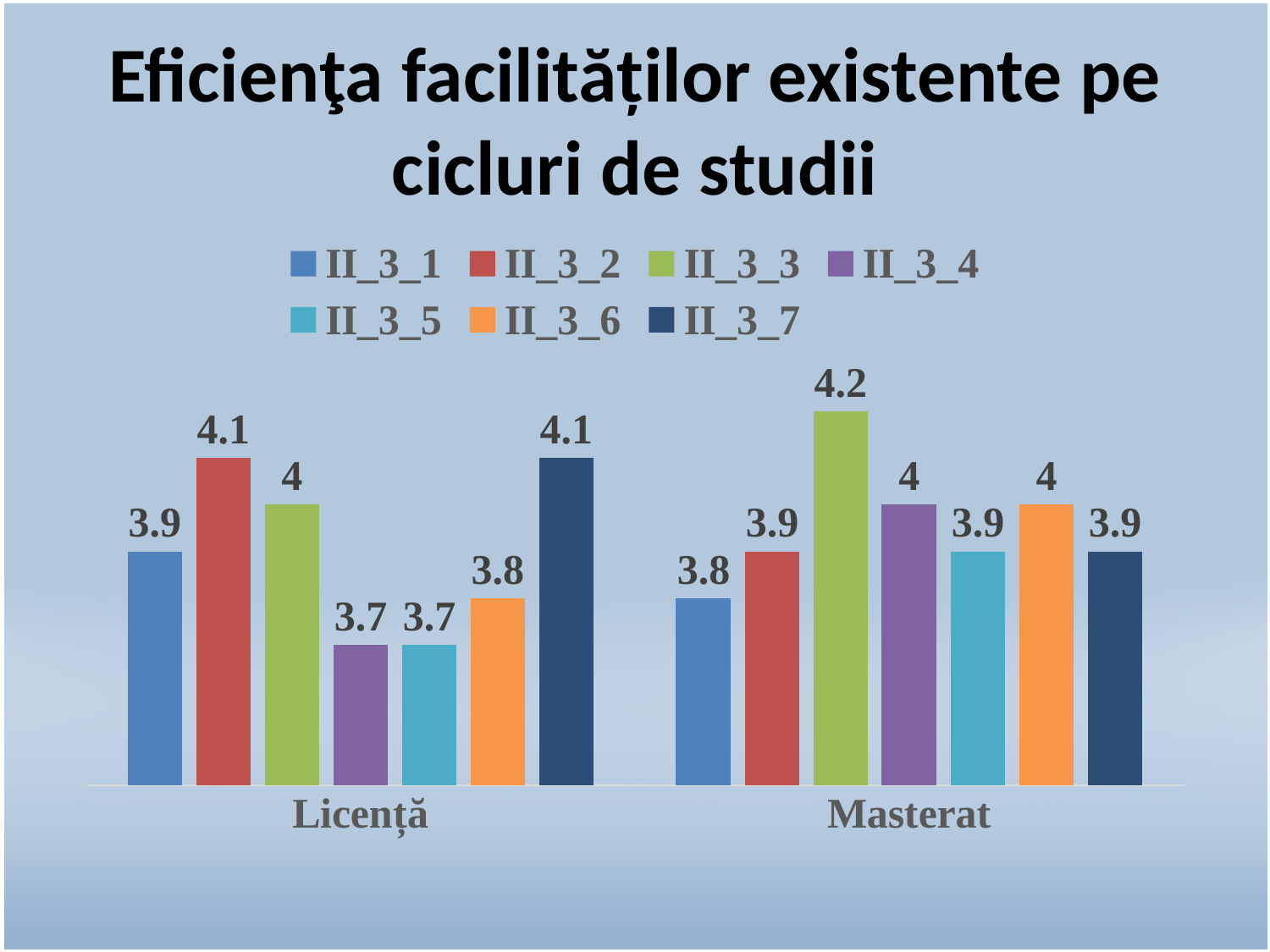
Which series has the highest value for Masterat? II_3_3 What is the difference between II_3_3 for Masterat and II_3_3 for Licență? 0.2 How many categories are shown on the x axis? 2 What is the difference between II_3_7 and II_3_4 for Licență? 0.4 What is the value of II_3_6 for Licență? 3.8 What is the value of II_3_3 for Masterat? 4.2 What kind of chart is shown on the slide? Bar chart Which series has the lowest value for Masterat? II_3_1 What is the value of II_3_1 for Masterat? 3.8 Which is larger: II_3_7 for Licență or II_3_7 for Masterat? II_3_7 for Licență What is the value of II_3_2 for Licență? 4.1 How many series does the legend list? 7